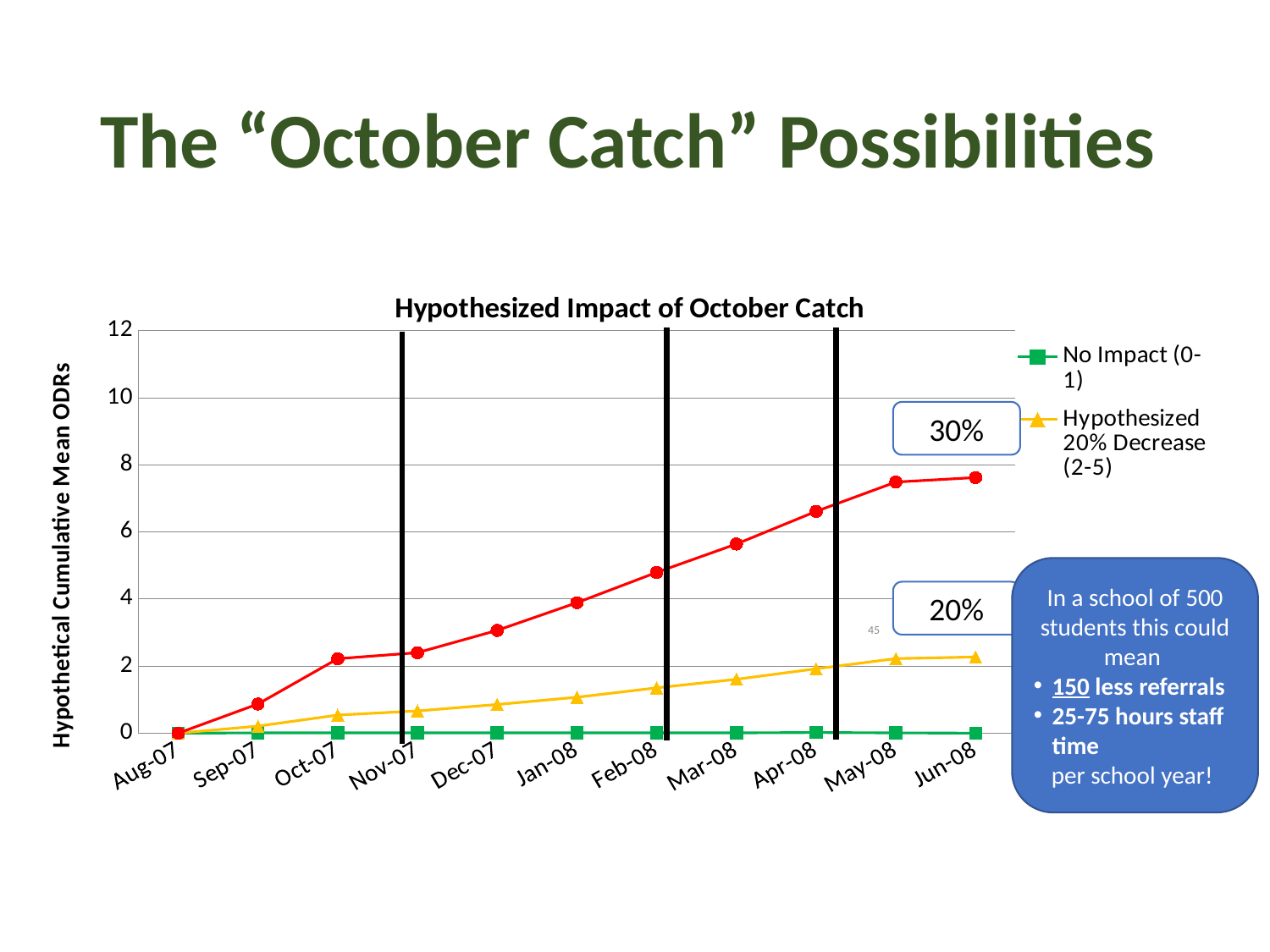
What is the label on the vertical axis of the chart? Hypothetical Cumulative Mean ODRs Is the value of the red line at Jun-08 greater or less than 8? less At Jun-08, which is larger: the red line or the Hypothesized 20% Decrease (2-5) series? the red line What type of chart is shown on the slide? line chart Is the value of the Hypothesized 20% Decrease (2-5) series at Jan-08 greater or less than 2? less Is the value of the red line at Jun-08 greater or less than 6? greater How many months are shown along the x axis of the chart? 11 At May-08, which is larger: the No Impact (0-1) series or the Hypothesized 20% Decrease (2-5) series? Hypothesized 20% Decrease (2-5) Does the red line rise or fall from Aug-07 to Jun-08? rise What is the title of the chart? Hypothesized Impact of October Catch